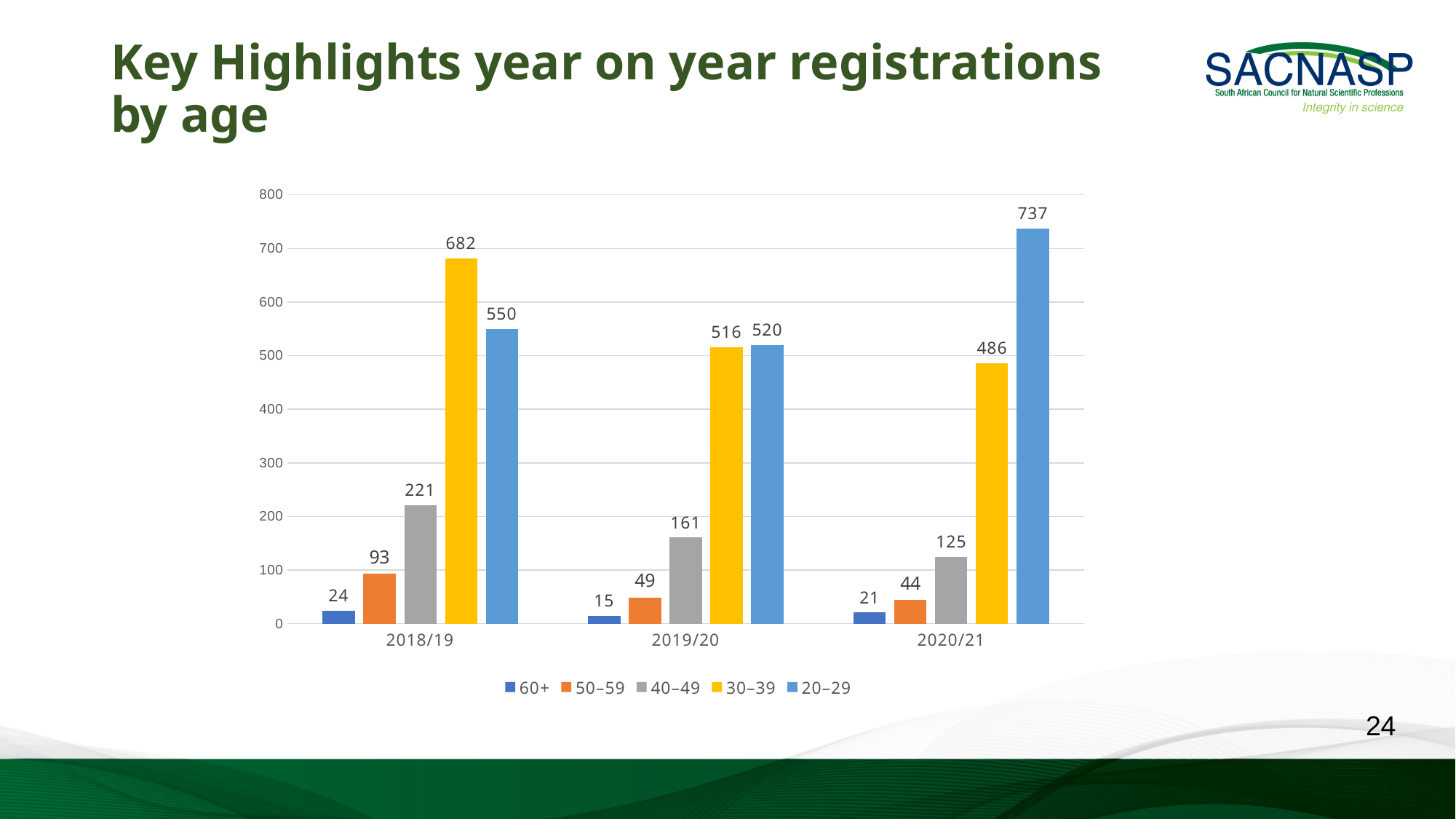
What is the value for the 20–29 age group in 2020/21? 737 Which is larger in 2018/19: the 30–39 value or the 20–29 value? 30–39 What kind of chart is shown on the slide? Bar chart What is the difference between the 20–29 and 30–39 values in 2020/21? 251 What is the value for the 60+ age group in 2019/20? 15 What is the value for the 30–39 age group in 2018/19? 682 Do the values for the 40–49 age group rise or fall from 2018/19 to 2020/21? Fall Which age group has the lowest value in 2018/19? 60+ How many year categories are shown on the x axis? 3 How many series does the legend list? 5 Which age group has the highest value in 2020/21? 20–29 What colour represents the 50–59 age group in the legend? Orange